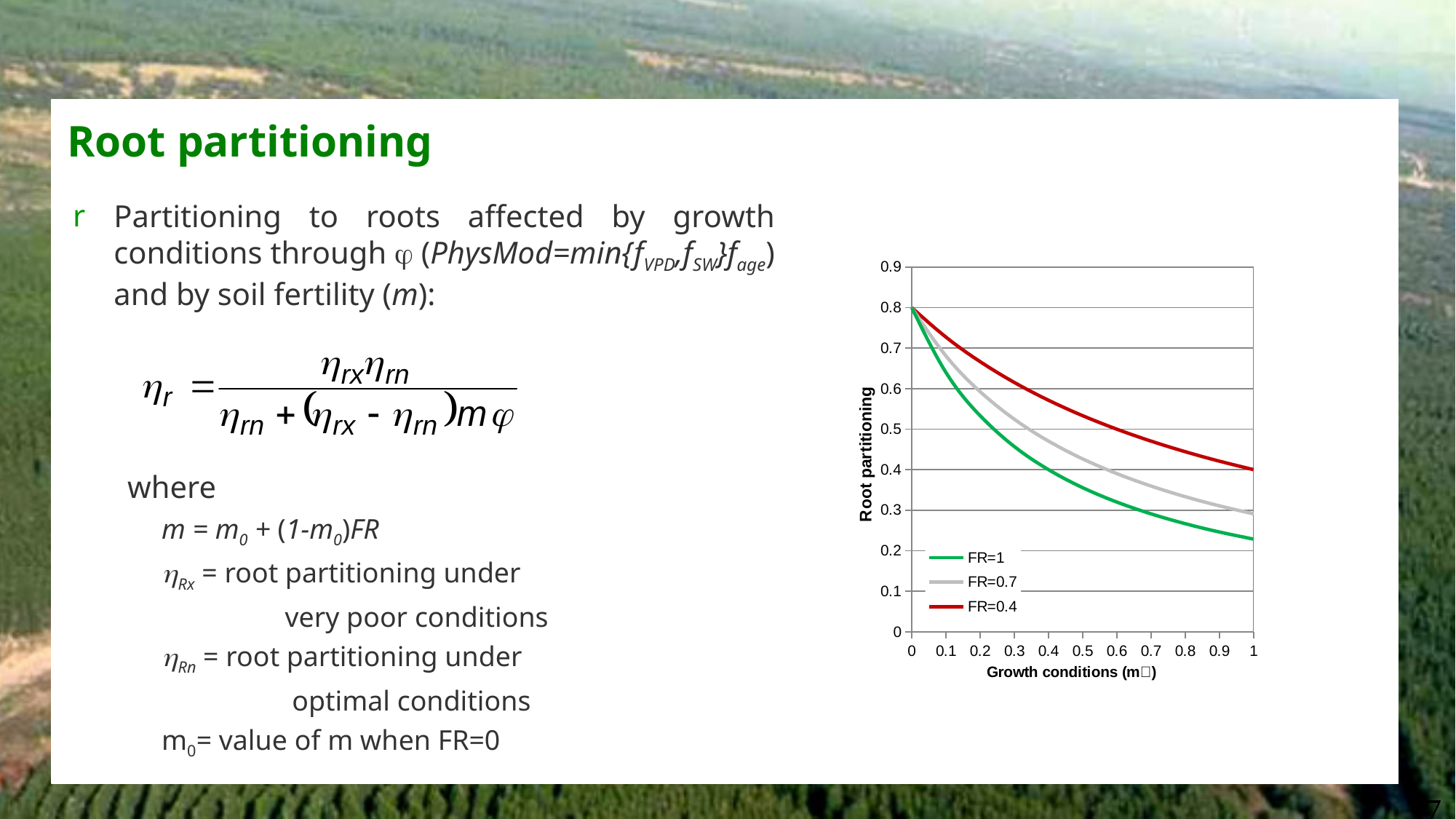
Is the root partitioning value for FR=1 at growth conditions = 0.5 greater or less than 0.4? less At growth conditions = 1, which series has the lowest root partitioning value? FR=1 What are the three series named in the chart legend? FR=1, FR=0.7, FR=0.4 At growth conditions = 1, which series has the highest root partitioning value? FR=0.4 What is the root partitioning value for FR=0.4 at growth conditions = 1? 0.4 What kind of chart is shown on the slide? line chart What is the root partitioning value for all three series at growth conditions = 0? 0.8 Do the root partitioning values rise or fall as growth conditions increase from 0 to 1? fall By how much does the root partitioning for FR=0.4 decrease between growth conditions = 0 and growth conditions = 1? 0.4 Is the root partitioning value for FR=1 at growth conditions = 1 greater or less than 0.3? less How many series does the chart legend list? 3 What is the title of the chart's y axis? Root partitioning